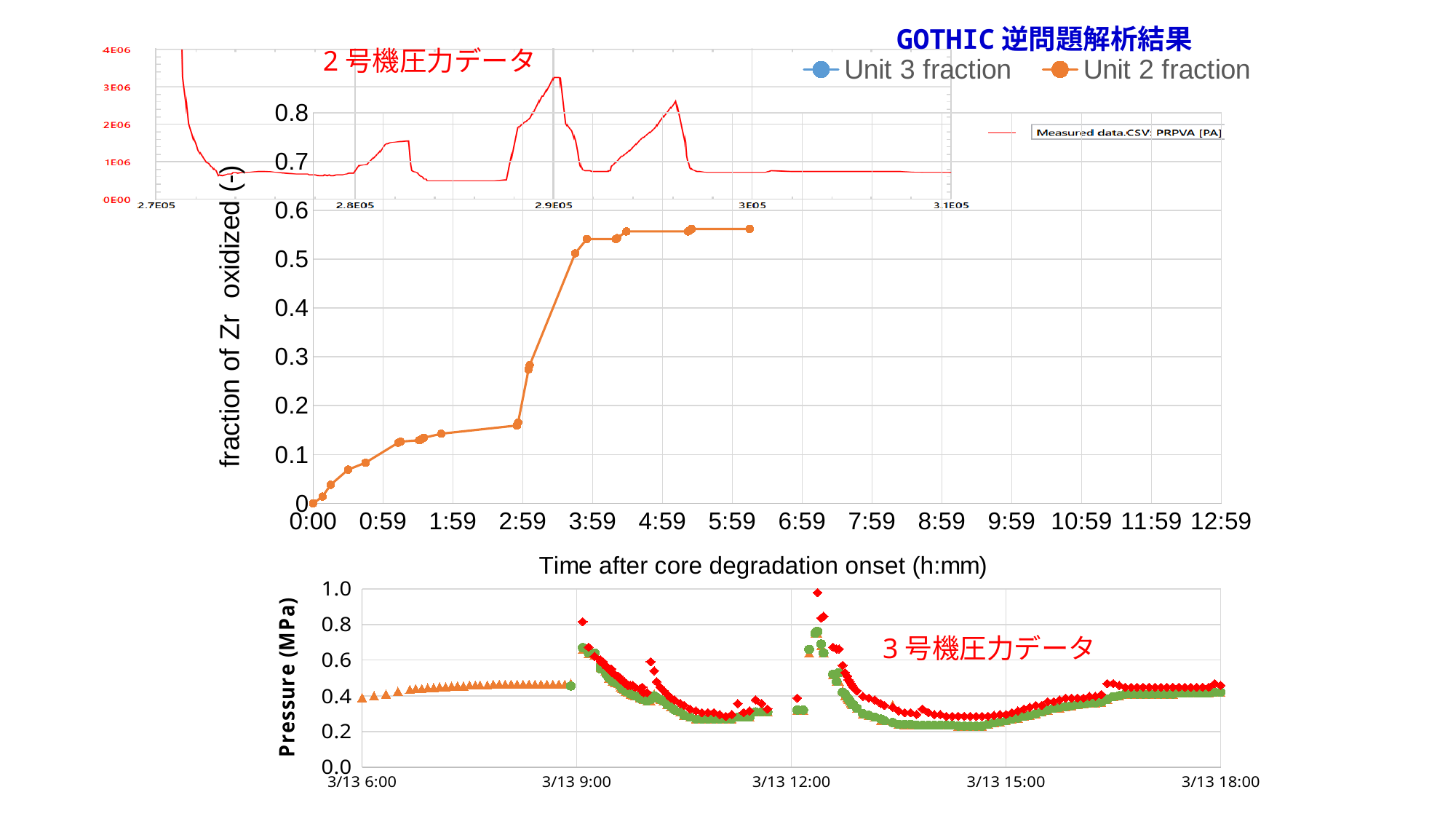
On the middle chart of fraction of Zr oxidized, is the Unit 2 fraction at 1:59 greater or less than 0.3? less On the top-left chart of 2号機圧力データ, what kind of chart is it? line chart On the middle chart of fraction of Zr oxidized, what is the label of the x axis? Time after core degradation onset (h:mm) On the middle chart of fraction of Zr oxidized, what kind of chart is it? line chart On the middle chart of fraction of Zr oxidized, is the Unit 2 fraction at 5:59 greater or less than 0.5? greater On the middle chart of fraction of Zr oxidized, does the Unit 2 fraction rise or fall as time increases? rise On the middle chart of fraction of Zr oxidized, is the Unit 2 fraction at 0:59 greater or less than 0.2? less On the middle chart of fraction of Zr oxidized, how many series does the legend list? 2 On the bottom chart of Pressure (MPa), what is the last time label shown on the x axis? 3/13 18:00